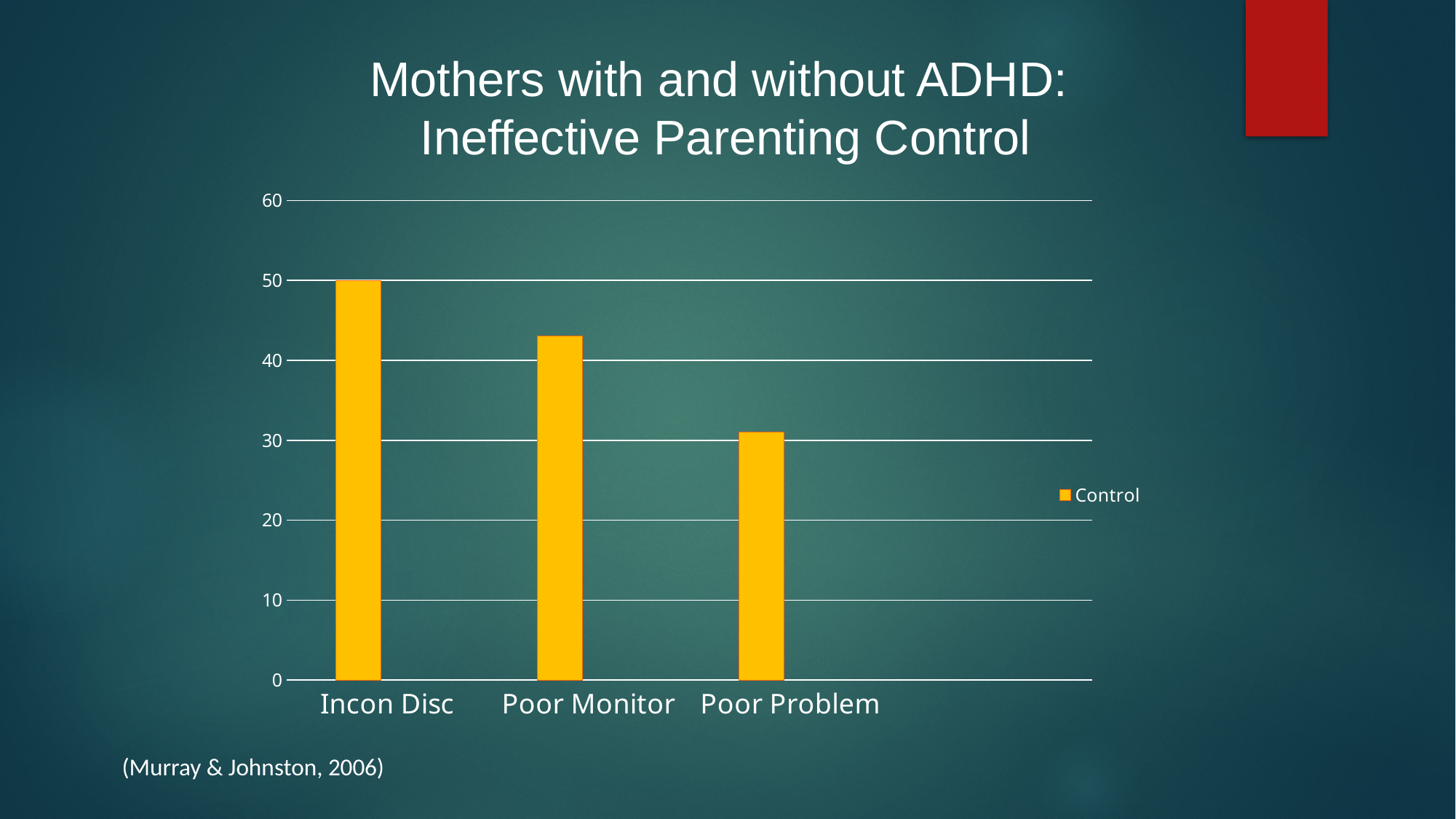
What is the value for Incon Disc? 50 How many series does the chart's legend list? 1 Is the value for Poor Problem greater or less than 40? less Which category has the lowest value? Poor Problem What kind of chart is shown on the slide? bar chart Which is larger, the value for Poor Monitor or the value for Poor Problem? Poor Monitor Is the value for Poor Monitor greater or less than 40? greater Which category has the highest value? Incon Disc How many categories are shown on the x axis of the chart? 3 What is the title of the chart on the slide? Mothers with and without ADHD: Ineffective Parenting Control Do the values rise or fall from left to right across the categories? fall What is the name of the series shown in the chart's legend? Control